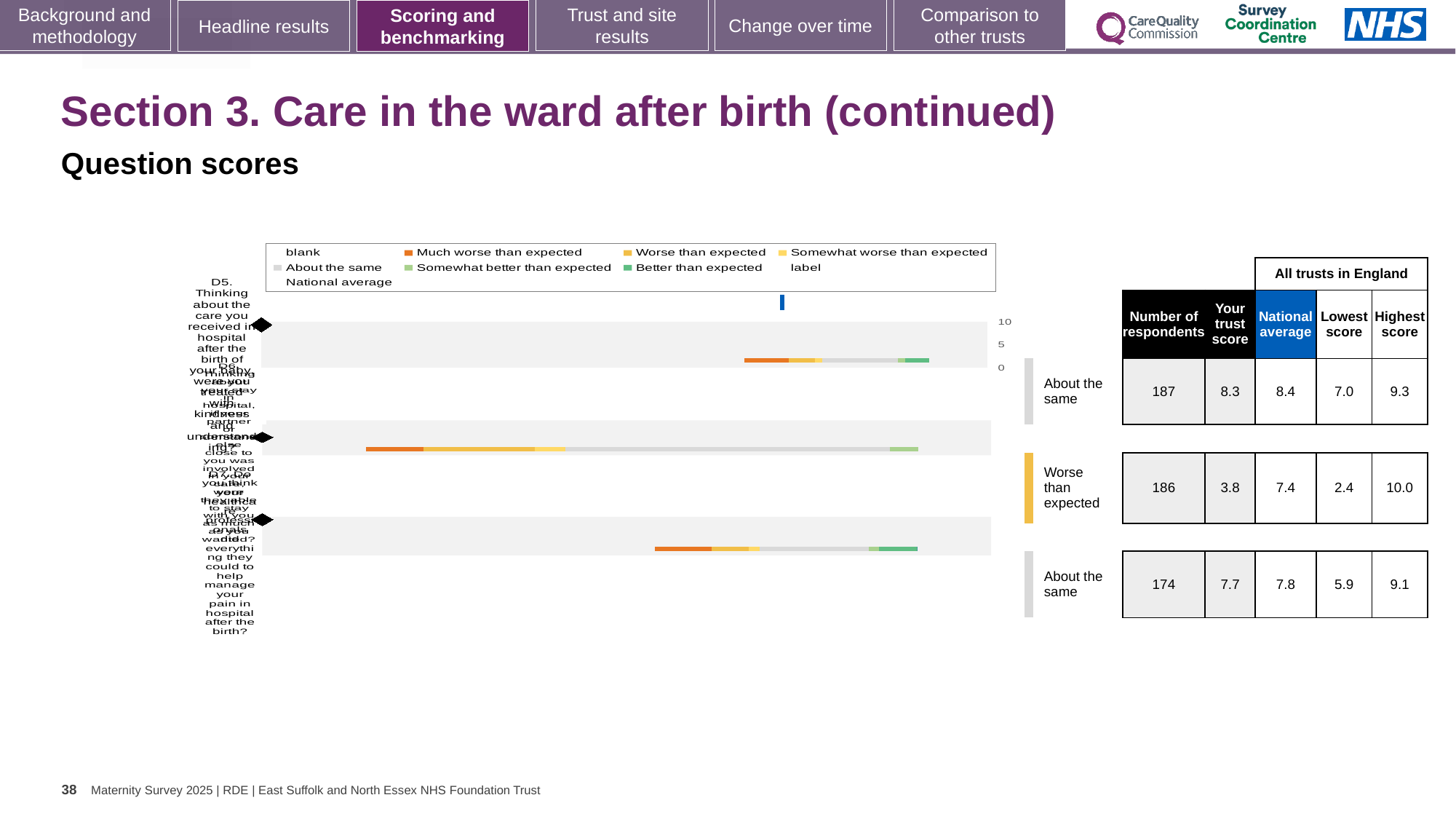
What benchmark label is shown beside the second bar of the chart? Worse than expected What benchmark label is shown beside the third bar of the chart? About the same How many bars (questions) are plotted in the chart? 3 What is the highest tick value shown on the chart's axis? 10 Which legend entry is shown in orange in the chart? Much worse than expected What benchmark label is shown beside the first bar of the chart? About the same Which legend entry is shown in dark green in the chart? Better than expected How many entries does the chart's legend list? 9 What kind of chart is shown on the slide? bar chart